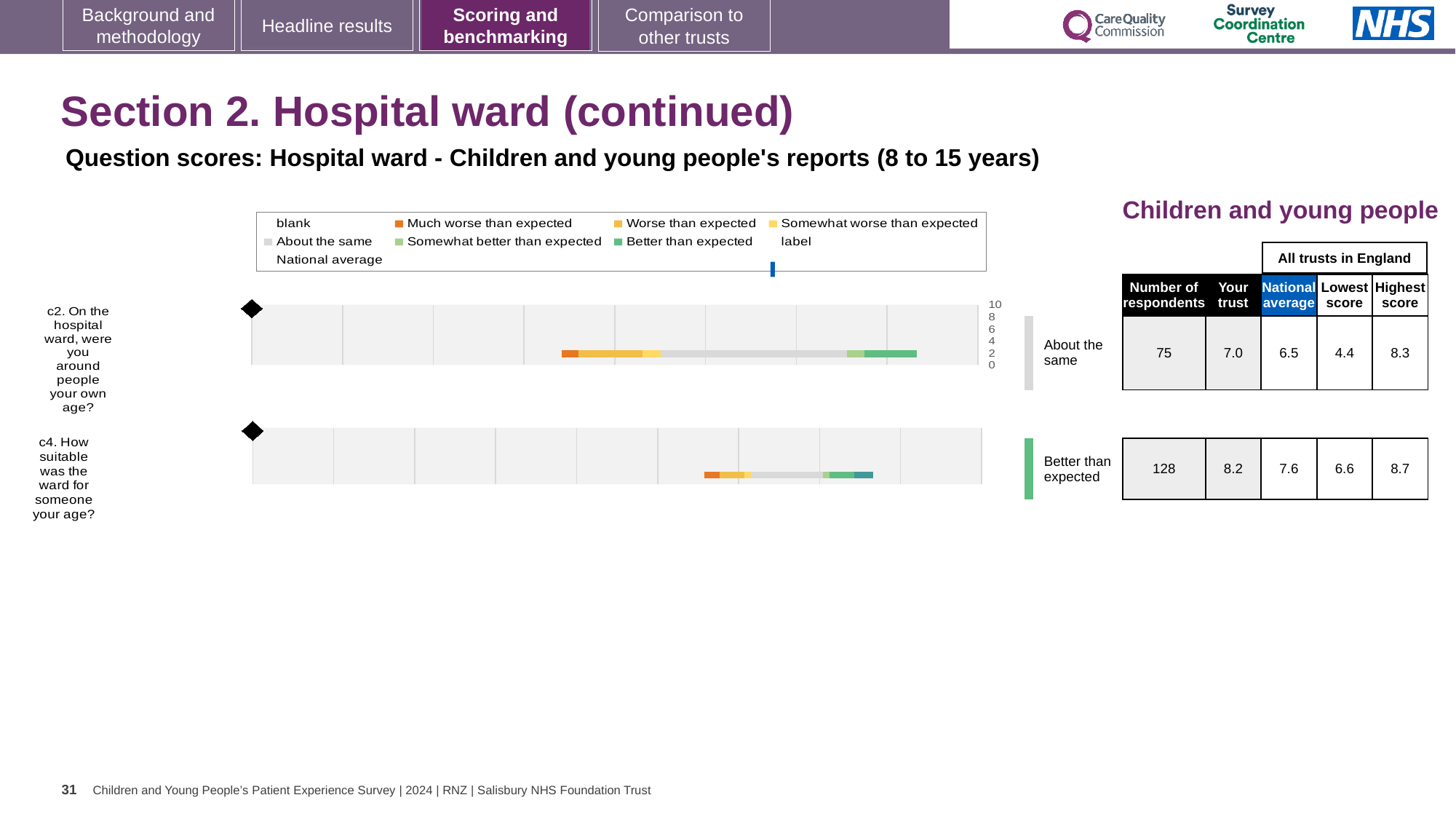
What is the 'Your trust' score for question c4 (How suitable was the ward for someone your age?)? 8.2 What is the difference between the highest and lowest scores for question c2? 3.9 Is the 'Your trust' score for question c2 greater or less than 6 on the chart's axis? greater What is the lowest score among all trusts in England for question c2? 4.4 What benchmark category is shown next to the chart for question c4? Better than expected How many respondents answered question c4? 128 What is the national average score for question c4? 7.6 What is the difference between the 'Your trust' scores for c4 and c2? 1.2 What is the 'Your trust' score for question c2 (On the hospital ward, were you around people your own age?)? 7.0 What kind of chart is used to show the question scores on this slide? Bar chart Which question has the higher 'Your trust' score, c2 or c4? c4 How many survey questions are plotted on the slide's charts? 2